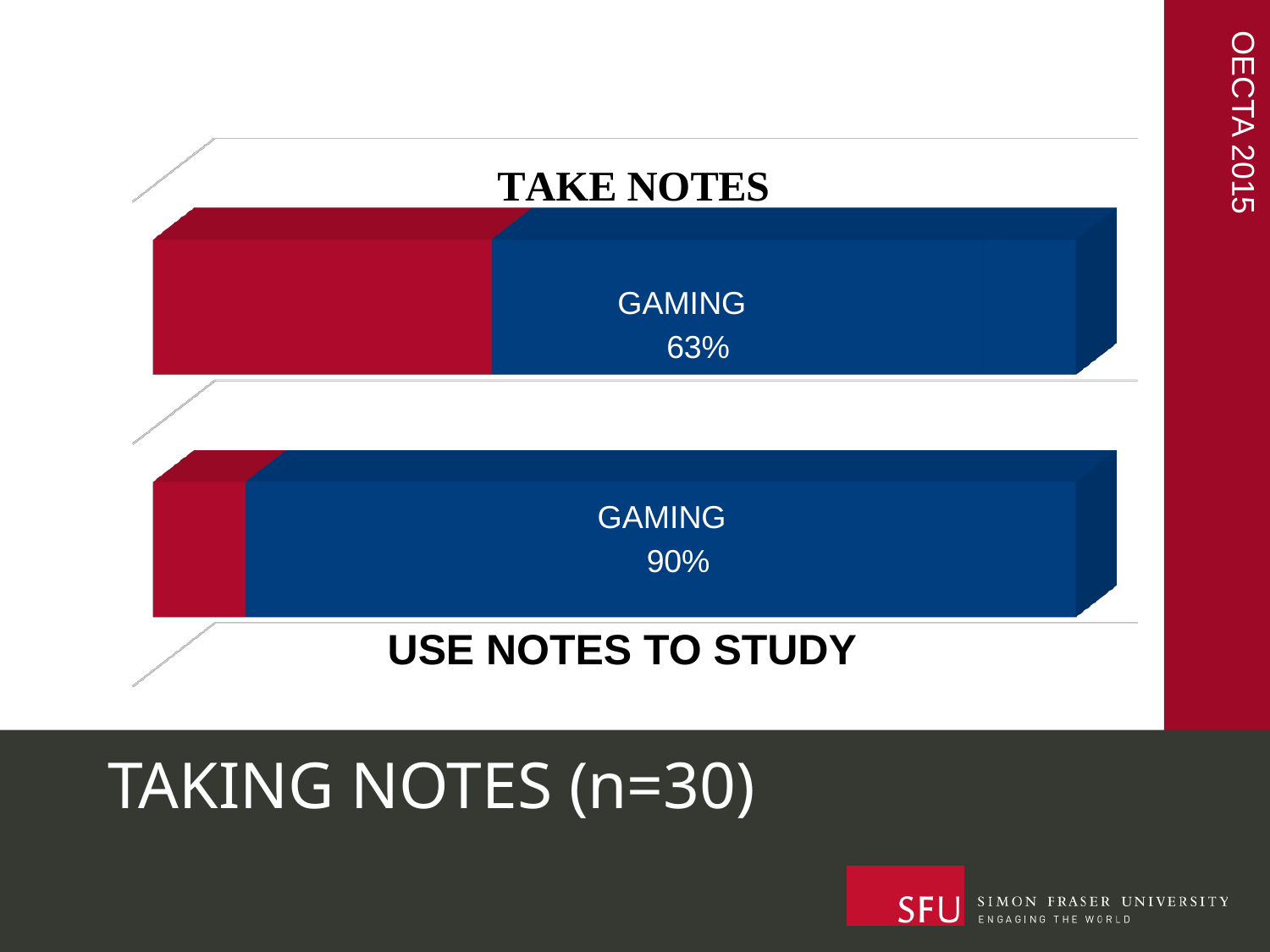
Which category has the highest GAMING percentage? USE NOTES TO STUDY Which category has the higher GAMING percentage, TAKE NOTES or USE NOTES TO STUDY? USE NOTES TO STUDY How many bars are shown in the chart? 2 What colour is the GAMING segment of each bar? Blue What is the difference in percentage points between the GAMING values for USE NOTES TO STUDY and TAKE NOTES? 27 What is the sample size (n) stated in the slide title? 30 What is the title text shown at the bottom of the slide? TAKING NOTES (n=30) What is the GAMING value shown on the USE NOTES TO STUDY bar? 90% What is the GAMING value shown on the TAKE NOTES bar? 63% Which category has the lowest GAMING percentage? TAKE NOTES What kind of chart is shown on the slide? Bar chart